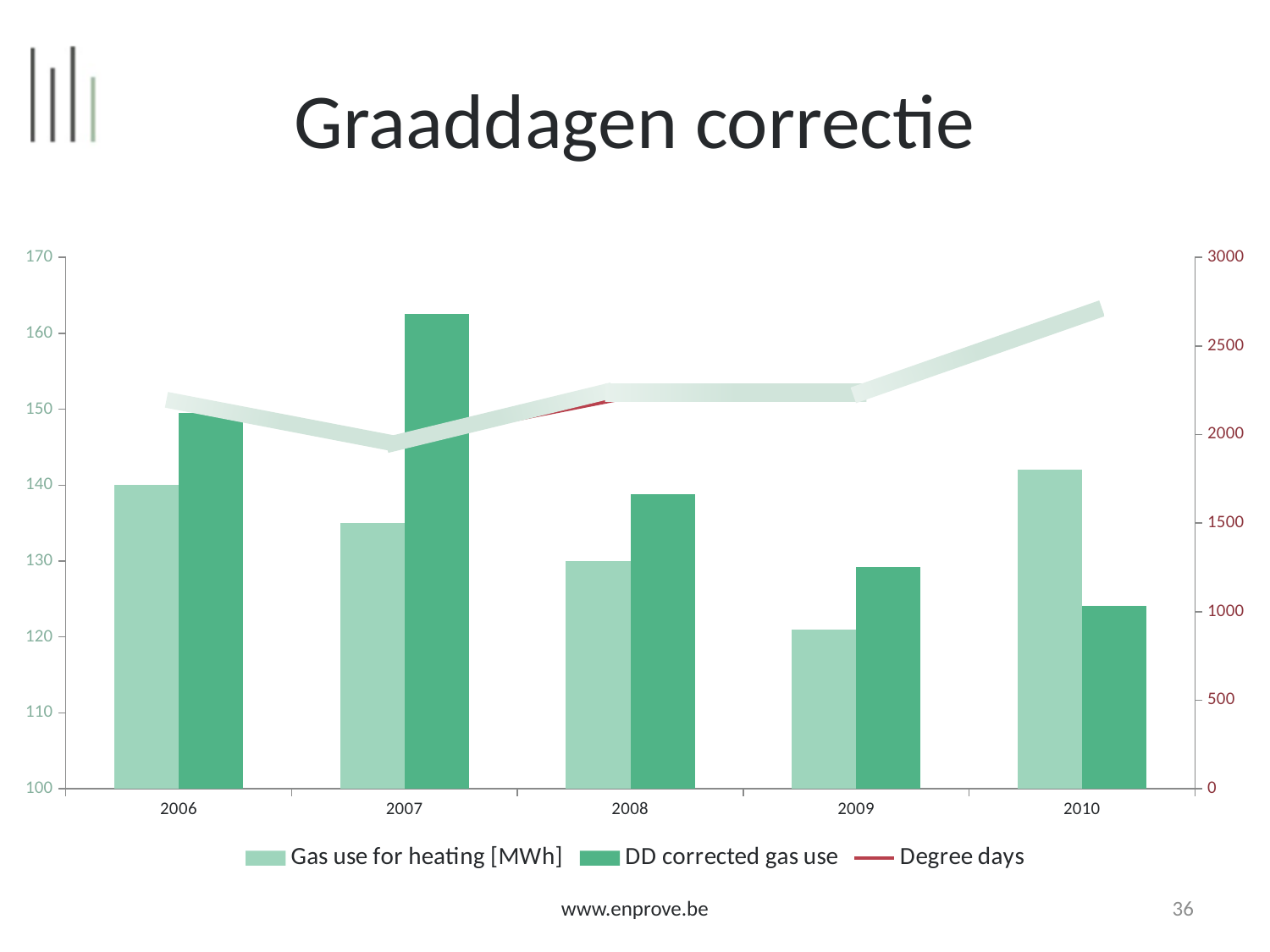
Is the Gas use for heating [MWh] for 2009 greater or less than 130? less What kind of chart is shown on the slide? bar chart with a line Is the DD corrected gas use for 2007 greater or less than 160? greater How many series does the legend list? 3 In which year is the DD corrected gas use highest? 2007 In 2010, which is larger: Gas use for heating [MWh] or DD corrected gas use? Gas use for heating [MWh] In which year is the DD corrected gas use lowest? 2010 In 2006, which is larger: Gas use for heating [MWh] or DD corrected gas use? DD corrected gas use In which year is the Gas use for heating [MWh] highest? 2010 How many years are shown on the x axis? 5 Does the Degree days line rise or fall from 2009 to 2010? rise In which year is the Gas use for heating [MWh] lowest? 2009